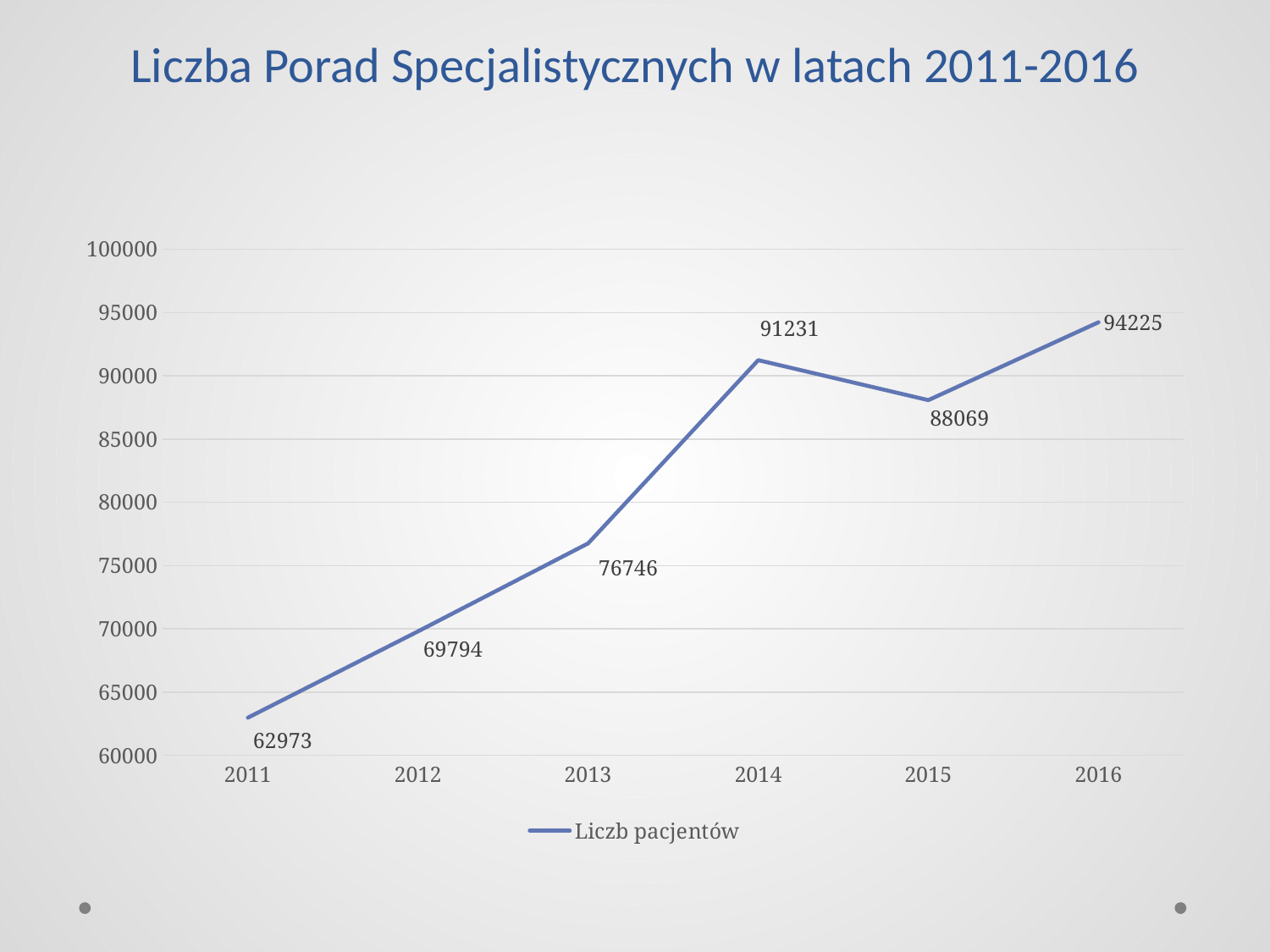
What is the difference between the values for 2016 and 2011? 31252 What is the title of the chart? Liczba Porad Specjalistycznych w latach 2011-2016 Is the value for 2012 greater or less than 70000? less Which year has the lowest value? 2011 What is the value for 2011? 62973 What is the value for 2016? 94225 What is the value for 2014? 91231 Which year has the highest value? 2016 Which is larger, the value for 2013 or the value for 2015? 2015 How many years are plotted on the chart? 6 What kind of chart is shown on the slide? line chart What is the difference between the values for 2014 and 2015? 3162